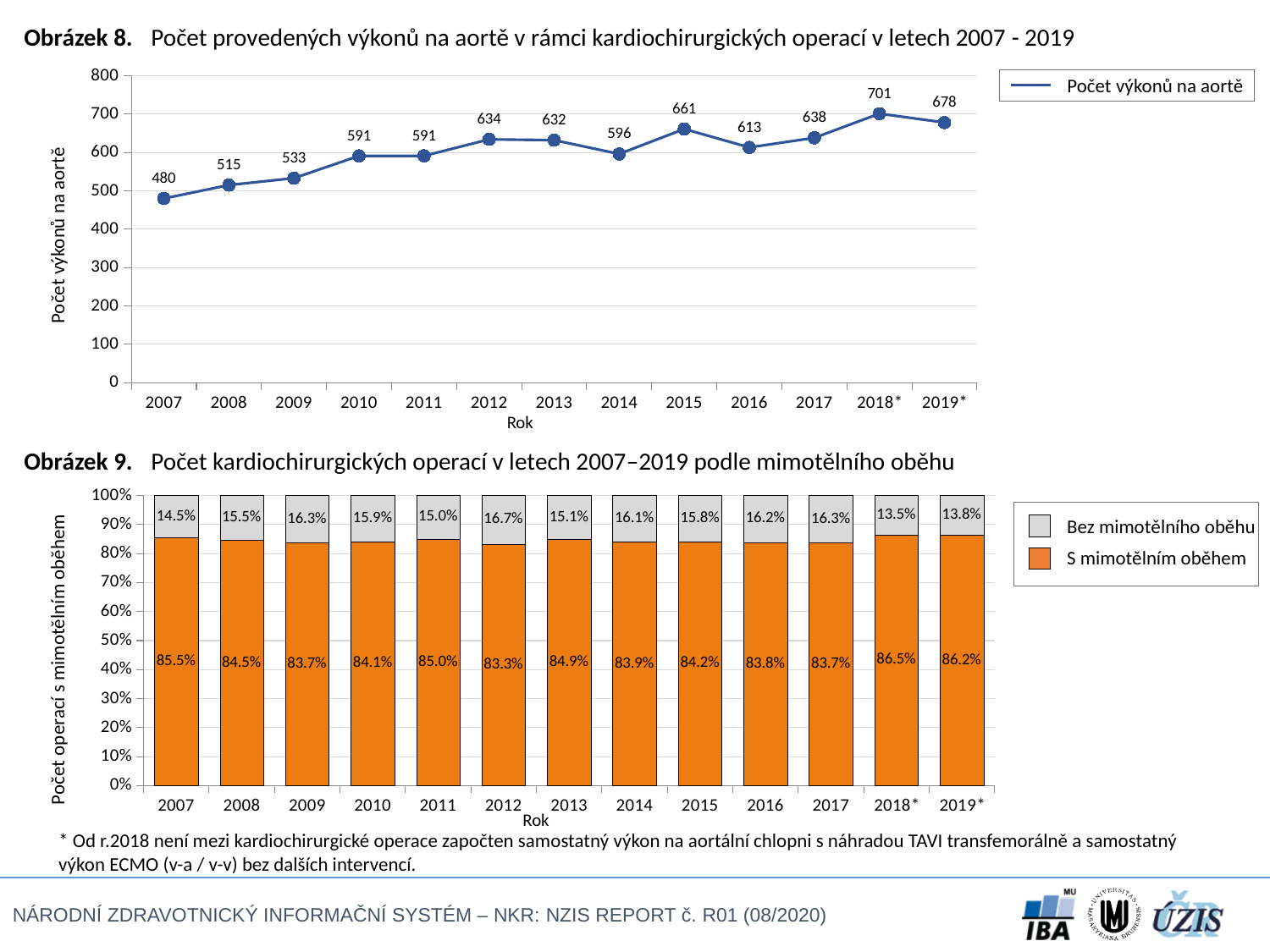
In the chart 'Obrázek 8', what is the difference between the values for 2018* and 2019*? 23 In the chart 'Obrázek 8', which year has the highest number of aortic procedures? 2018* In the chart 'Obrázek 8', which year has the lowest number of aortic procedures? 2007 In the chart 'Obrázek 9', what is the share of 'S mimotělním oběhem' in 2012? 83.3% In the chart 'Obrázek 8', what is the number of aortic procedures in 2010? 591 In the chart 'Obrázek 8', do the values generally rise or fall from 2007 to 2012? rise In the chart 'Obrázek 8', which year has a larger value, 2015 or 2016? 2015 In the chart 'Obrázek 9', how many series does the legend list? 2 What kind of chart is 'Obrázek 8'? line chart In the chart 'Obrázek 9', which year has the highest share of 'Bez mimotělního oběhu'? 2012 What kind of chart is 'Obrázek 9'? stacked bar chart In the chart 'Obrázek 8', how many years are shown on the x axis? 13